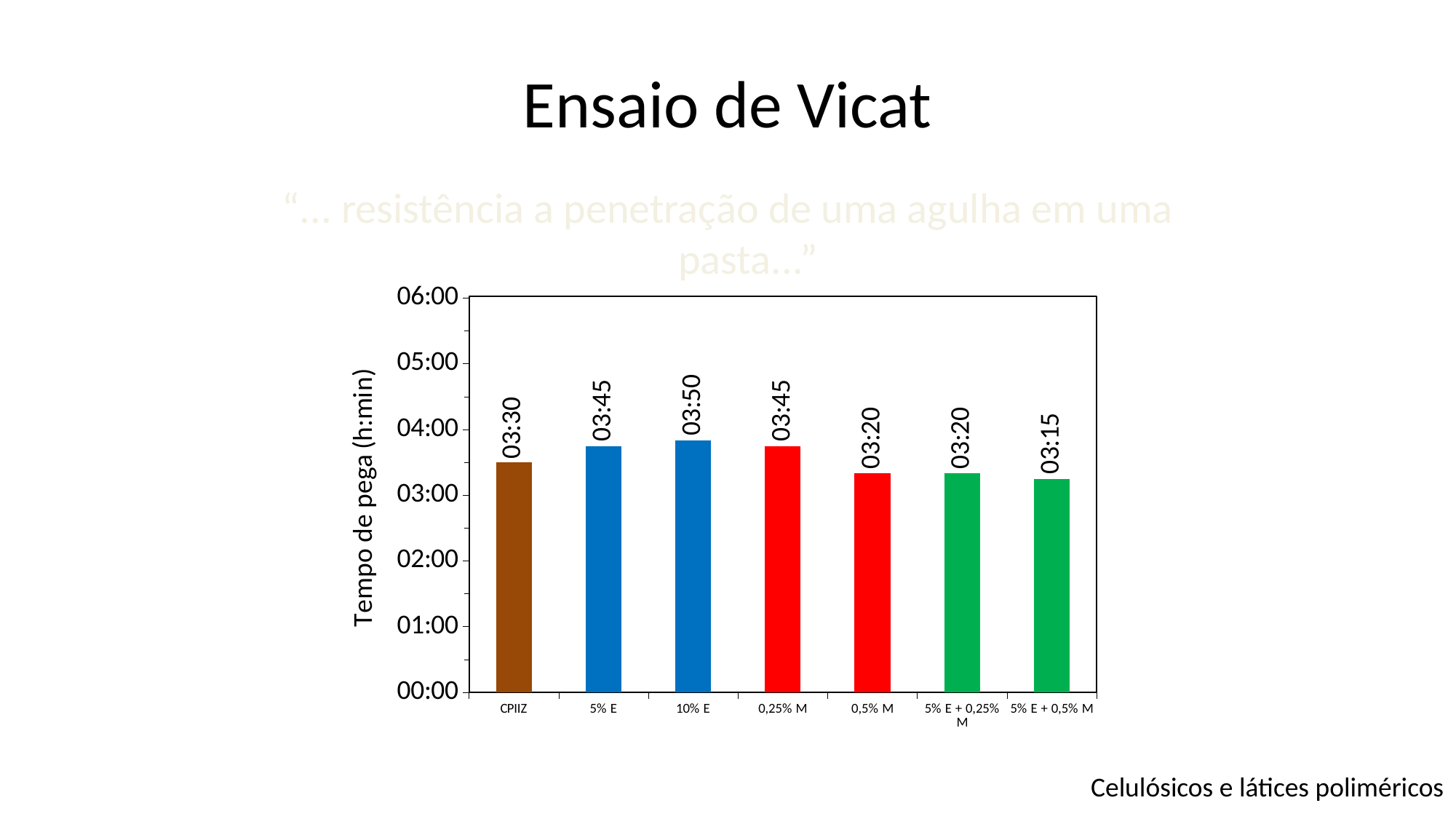
Which has a longer setting time, 5% E or 0,5% M? 5% E What is the difference between the setting time for 10% E and for CPIIZ? 00:20 What is the value shown for 5% E + 0,5% M? 03:15 What is the setting time (Tempo de pega) shown for CPIIZ? 03:30 How many categories (bars) are shown in the chart? 7 What is the label of the vertical axis? Tempo de pega (h:min) What is the value shown for 0,5% M? 03:20 Is the value for 0,25% M greater or less than 04:00? less What is the value shown for the 10% E bar? 03:50 What kind of chart is shown on the slide? Bar chart Which category has the lowest setting time? 5% E + 0,5% M Which category has the highest setting time? 10% E